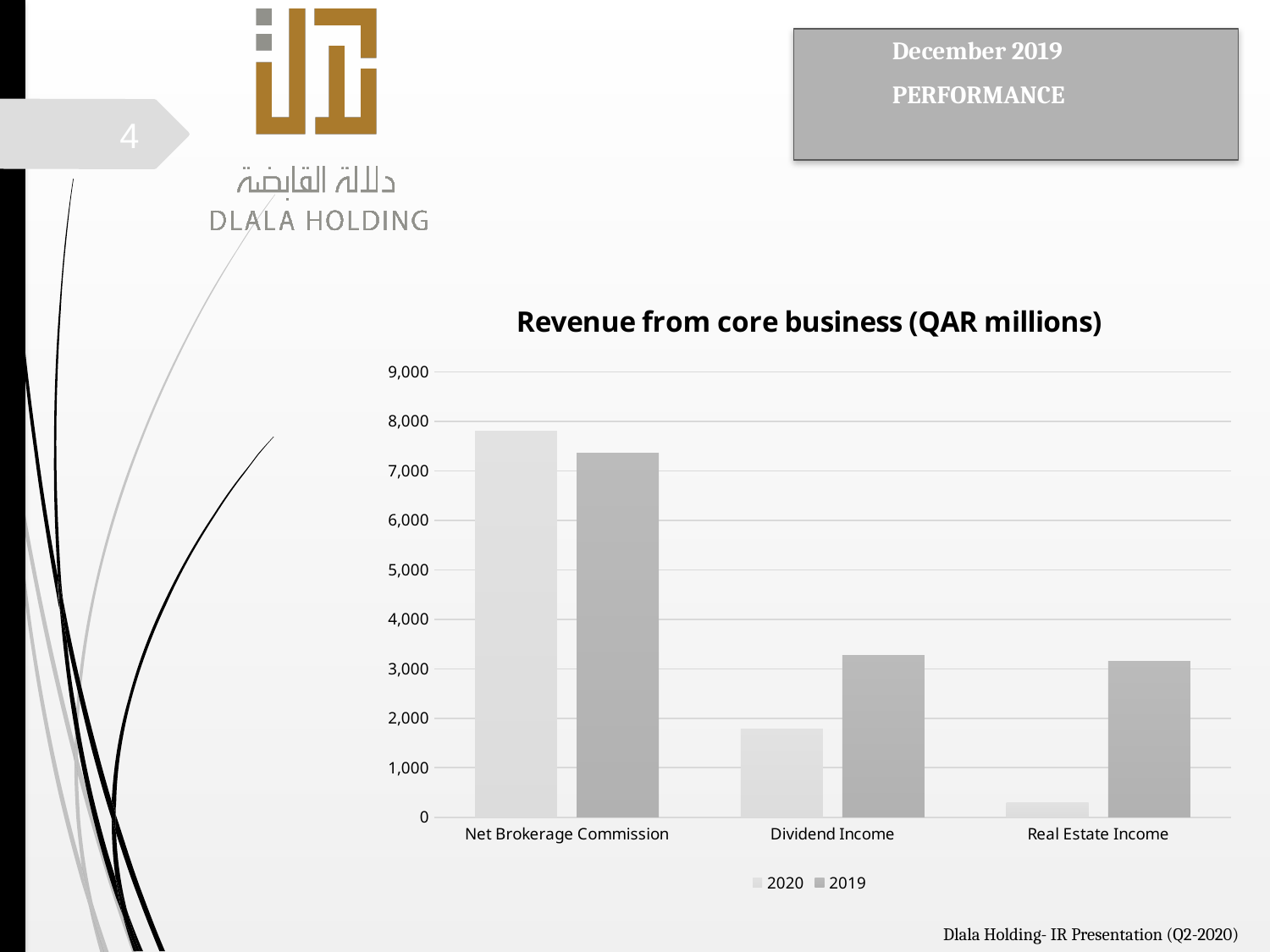
For Dividend Income, which is larger, the 2020 value or the 2019 value? 2019 Is the 2020 value for Net Brokerage Commission greater or less than 7,000? greater Which category has the lowest value for 2019? Real Estate Income For Net Brokerage Commission, which is larger, the 2020 value or the 2019 value? 2020 Which series are listed in the legend? 2020 and 2019 What is the title of the chart? Revenue from core business (QAR millions) Which category has the highest value for 2020? Net Brokerage Commission What kind of chart is shown on the slide? bar chart Is the 2020 value for Real Estate Income greater or less than 1,000? less How many categories are shown on the x axis? 3 Which category has the lowest value for 2020? Real Estate Income How many series does the legend list? 2